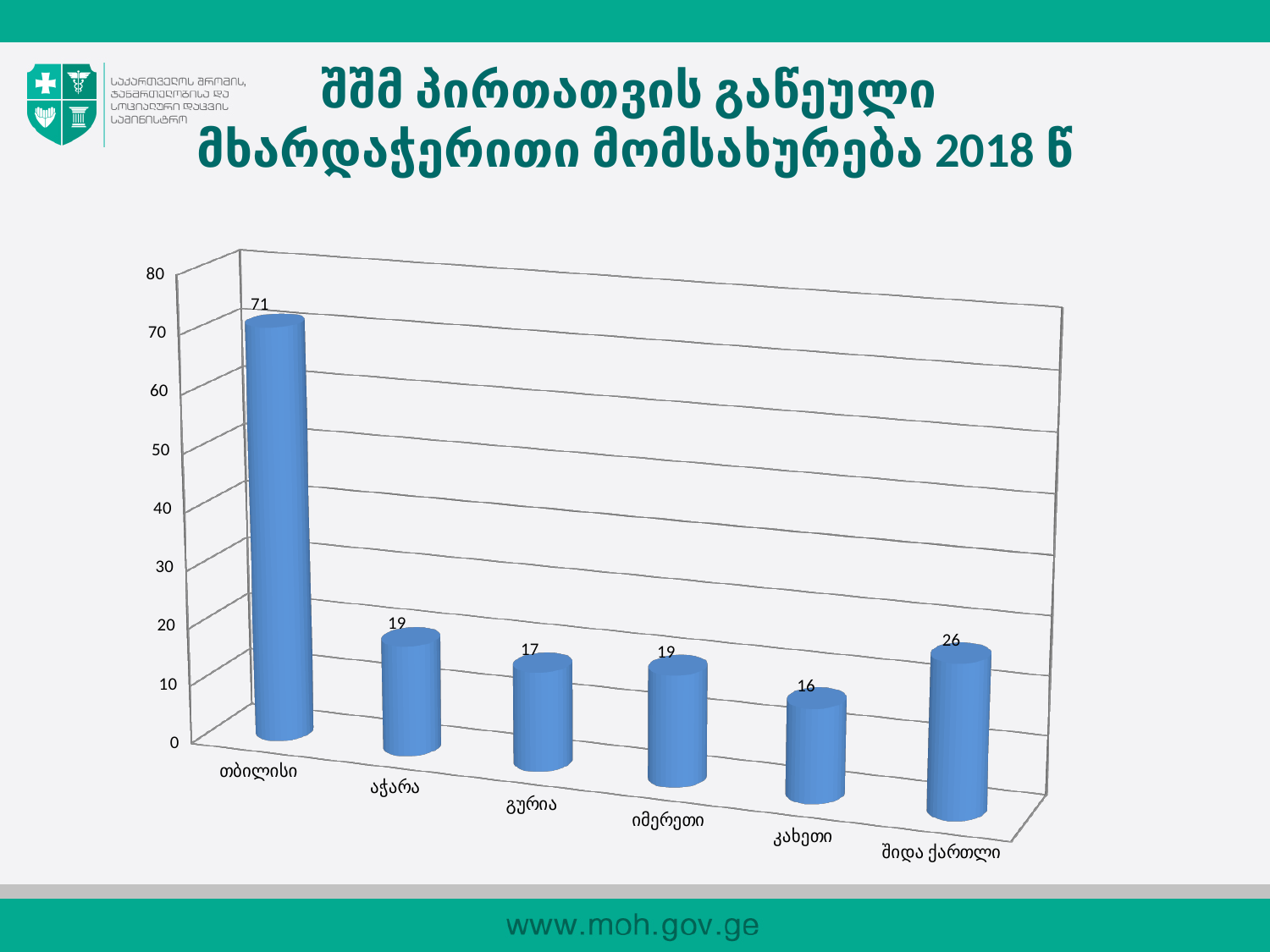
What kind of chart is shown on the slide? bar chart What is the value for შიდა ქართლი? 26 What is the difference between the values for თბილისი and შიდა ქართლი? 45 What is the value for კახეთი? 16 Is the value for თბილისი greater or less than 60? greater What is the value for თბილისი? 71 What year is mentioned in the chart title? 2018 Which is larger, the value for აჭარა or the value for კახეთი? აჭარა How many categories are shown on the x axis? 6 What is the value for გურია? 17 Which category has the lowest value? კახეთი Which category has the highest value? თბილისი